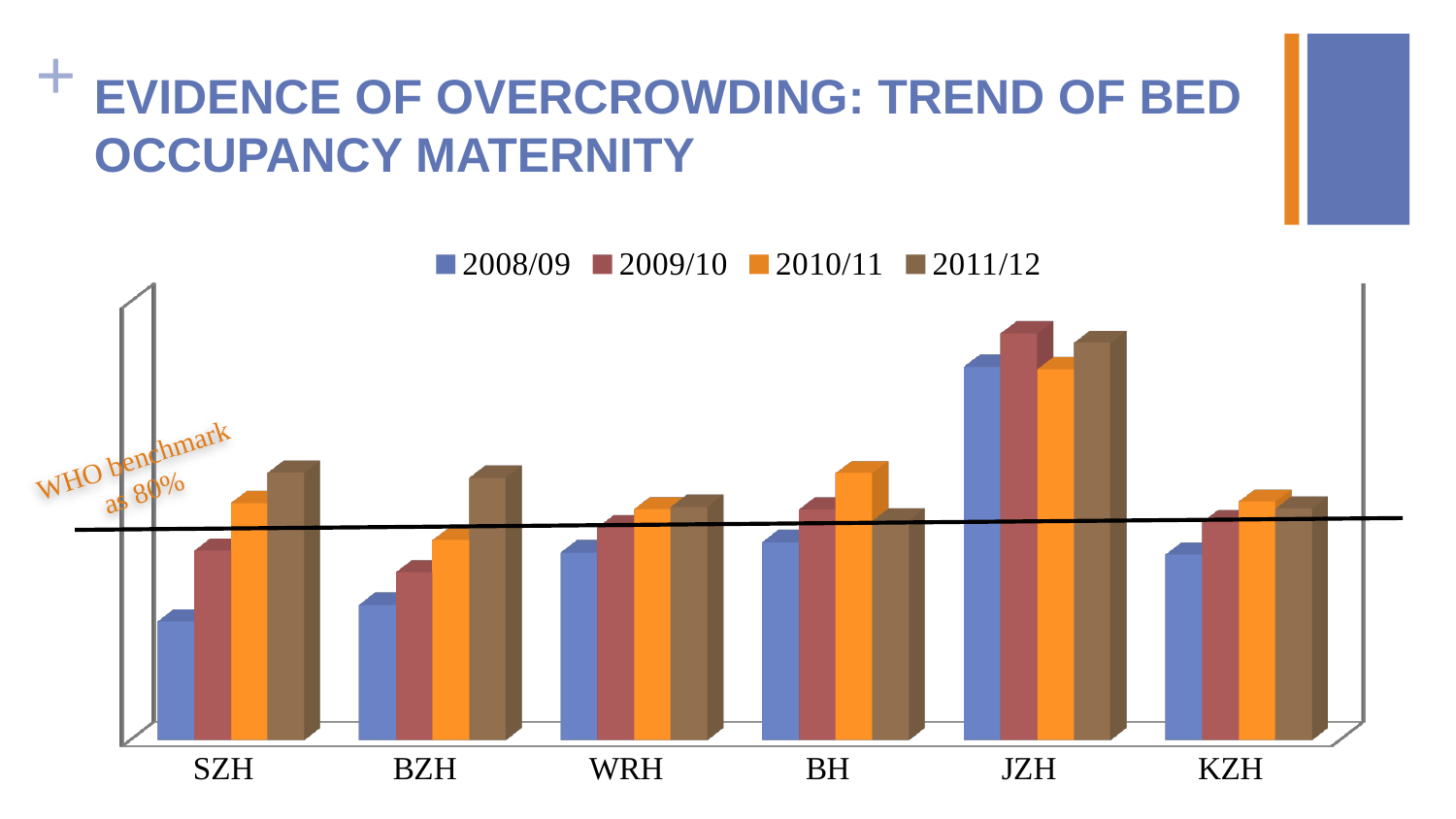
Which hospital has the highest bed occupancy in 2011/12? JZH Which is larger, the 2008/09 value for JZH or the 2008/09 value for BZH? JZH How many hospitals (categories) are shown on the x axis? 6 Is the value for JZH in 2010/11 greater or less than 80%? greater Which hospital has the highest bed occupancy in 2008/09? JZH Is the value for KZH in 2008/09 greater or less than 80%? less Is the value for BZH in 2011/12 greater or less than 80%? greater Do the values for SZH rise or fall from 2008/09 to 2011/12? rise What benchmark does the horizontal line on the chart represent? WHO benchmark as 80% How many series does the legend list? 4 What kind of chart is shown on the slide? bar chart